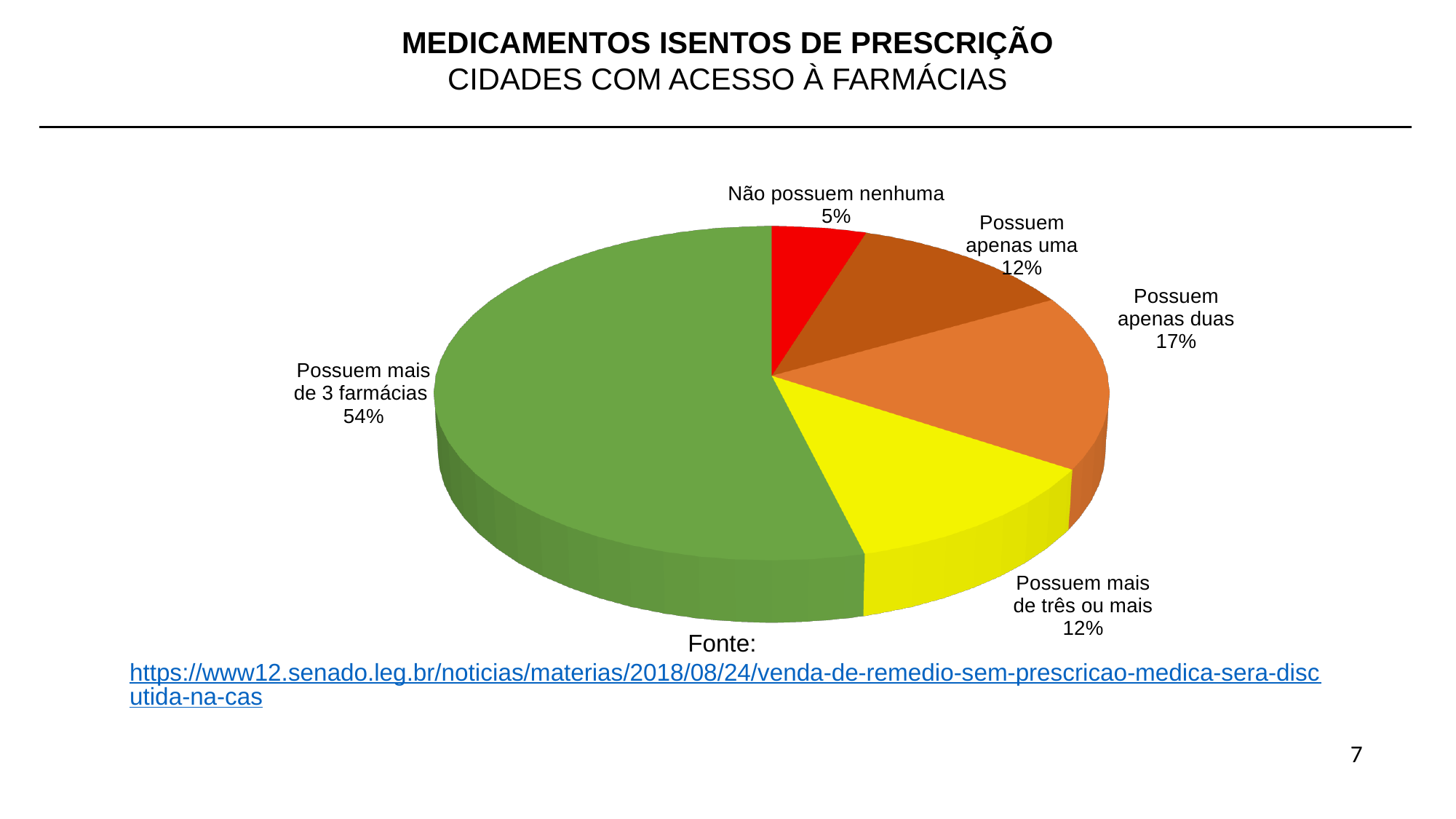
Which category has the smallest share of the pie? Não possuem nenhuma What percentage of cities is shown for "Possuem mais de 3 farmácias"? 54% How many slices does the pie chart have? 5 What colour is the slice for "Não possuem nenhuma"? red Which category has the largest share of the pie? Possuem mais de 3 farmácias What kind of chart is shown on the slide? pie chart What is the combined percentage of "Possuem apenas uma" and "Possuem apenas duas"? 29% What is the difference in percentage points between "Possuem mais de 3 farmácias" and "Possuem apenas duas"? 37 What percentage is shown for "Não possuem nenhuma"? 5% What percentage is shown for "Possuem apenas duas"? 17% What percentage is shown for "Possuem apenas uma"? 12% Which is larger, the share for "Possuem apenas duas" or the share for "Não possuem nenhuma"? Possuem apenas duas